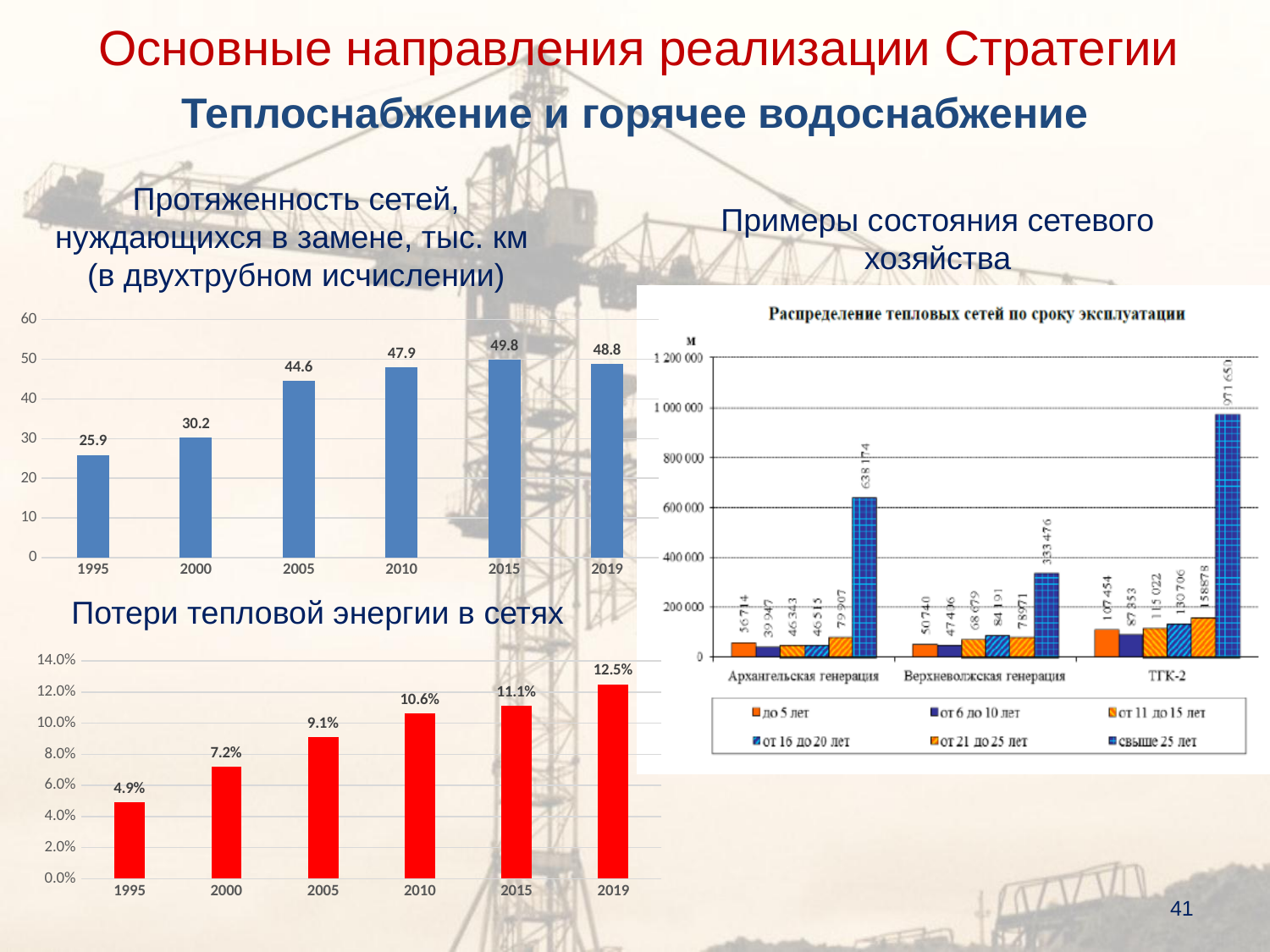
In the chart 'Протяженность сетей, нуждающихся в замене', what is the difference between the values for 2019 and 1995? 22.9 In the chart 'Потери тепловой энергии в сетях', do the values rise or fall from 1995 to 2019? rise In the chart 'Протяженность сетей, нуждающихся в замене', which year has the highest value? 2015 In the chart 'Протяженность сетей, нуждающихся в замене', how many years are shown on the x axis? 6 In the chart 'Потери тепловой энергии в сетях', what is the difference between the values for 2019 and 2015? 1.4% In the chart 'Протяженность сетей, нуждающихся в замене', which year has the lowest value? 1995 In the chart 'Распределение тепловых сетей по сроку эксплуатации', what is the value of 'свыше 25 лет' for ТГК-2? 971 650 What kind of chart is 'Потери тепловой энергии в сетях'? bar chart In the chart 'Распределение тепловых сетей по сроку эксплуатации', how many series does the legend list? 6 In the chart 'Потери тепловой энергии в сетях', what is the value for 2010? 10.6% In the chart 'Протяженность сетей, нуждающихся в замене', what is the value for 2005? 44.6 In the chart 'Потери тепловой энергии в сетях', which is larger, the value for 2000 or the value for 2005? 2005